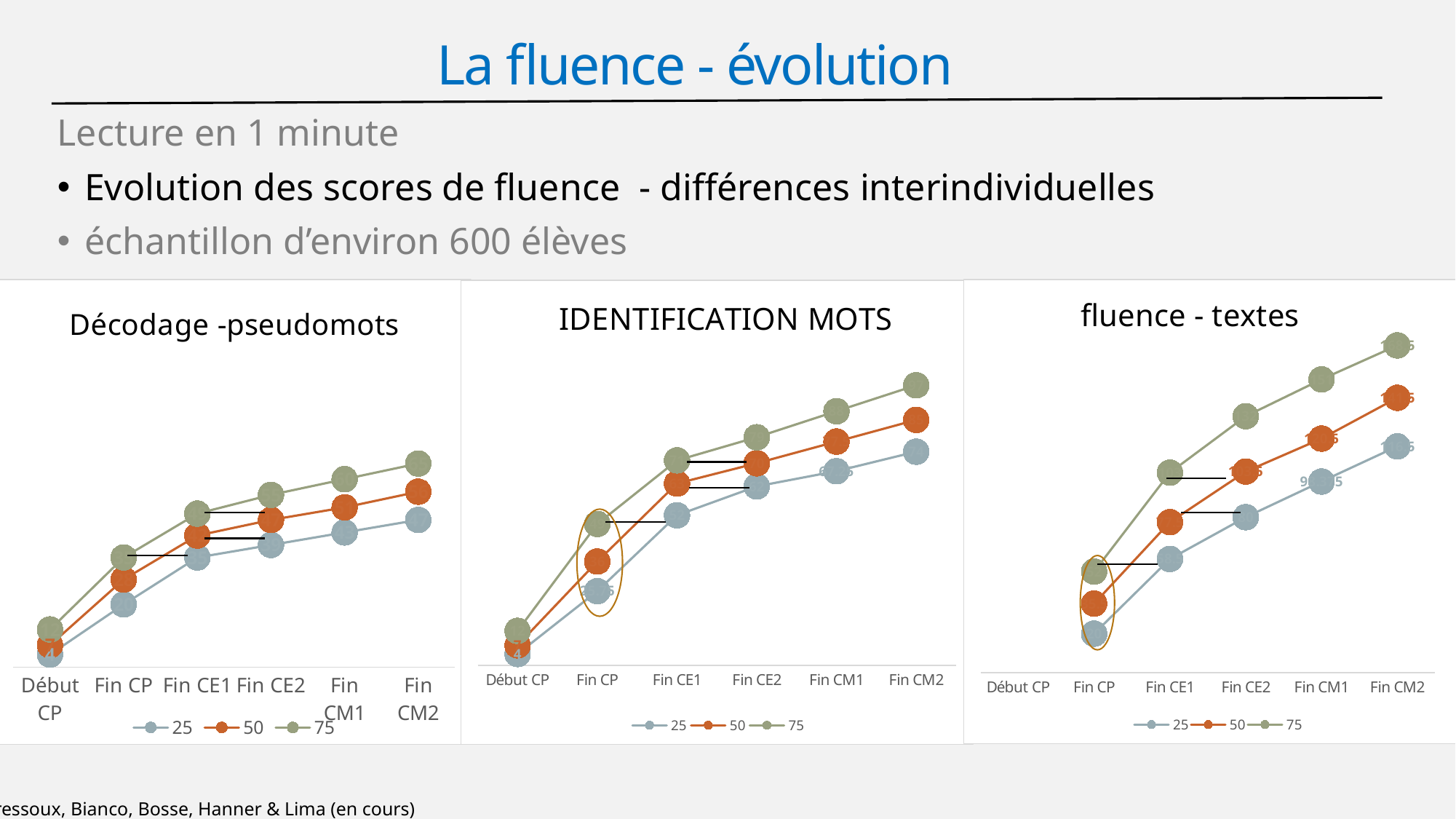
What is the first category on the x axis of the 'Décodage -pseudomots' chart? Début CP In the 'fluence - textes' chart, which series has the highest value at Fin CM2? 75 What is the title of the rightmost chart on the slide? fluence - textes How many categories are shown on the x axis of the 'IDENTIFICATION MOTS' chart? 6 What kind of chart is the 'Décodage -pseudomots' chart? line chart In the 'IDENTIFICATION MOTS' chart, at Fin CP, which is larger: the value for the 50 series or the 25 series? 50 In the 'IDENTIFICATION MOTS' chart, which series has the lowest value at Fin CM2? 25 In the 'Décodage -pseudomots' chart, do the values of the 75 series rise or fall from Début CP to Fin CM2? rise In the 'Décodage -pseudomots' chart, at Fin CE1, which is larger: the value for the 75 series or the 25 series? 75 How many series does the legend of the 'fluence - textes' chart list? 3 In the 'fluence - textes' chart, do the values of the 25 series rise or fall along the x axis? rise What are the legend entries of the 'IDENTIFICATION MOTS' chart? 25, 50, 75